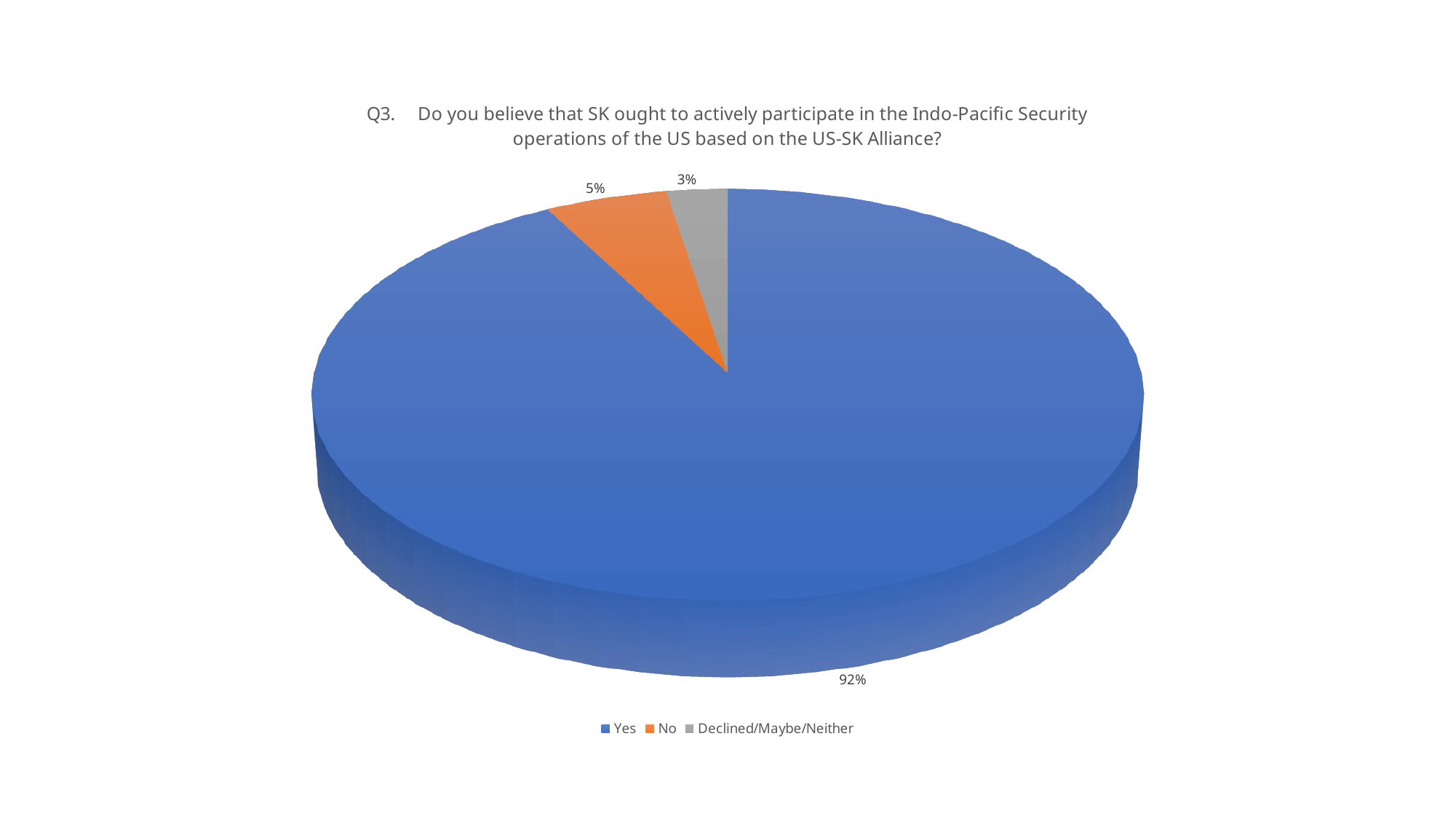
Which is larger, the "No" slice or the "Declined/Maybe/Neither" slice? No What share of the pie is labelled "Declined/Maybe/Neither"? 3% What is the title of the chart? Q3. Do you believe that SK ought to actively participate in the Indo-Pacific Security operations of the US based on the US-SK Alliance? What is the difference in percentage points between the "Yes" and "No" slices? 87 Which category has the largest slice of the pie? Yes What is the difference in percentage points between the "No" and "Declined/Maybe/Neither" slices? 2 What share of the pie is labelled "No"? 5% Which category has the smallest slice of the pie? Declined/Maybe/Neither What share of the pie is labelled "Yes"? 92% What colour is the "Yes" slice? Blue How many categories does the legend list? 3 What kind of chart is shown on the slide? Pie chart